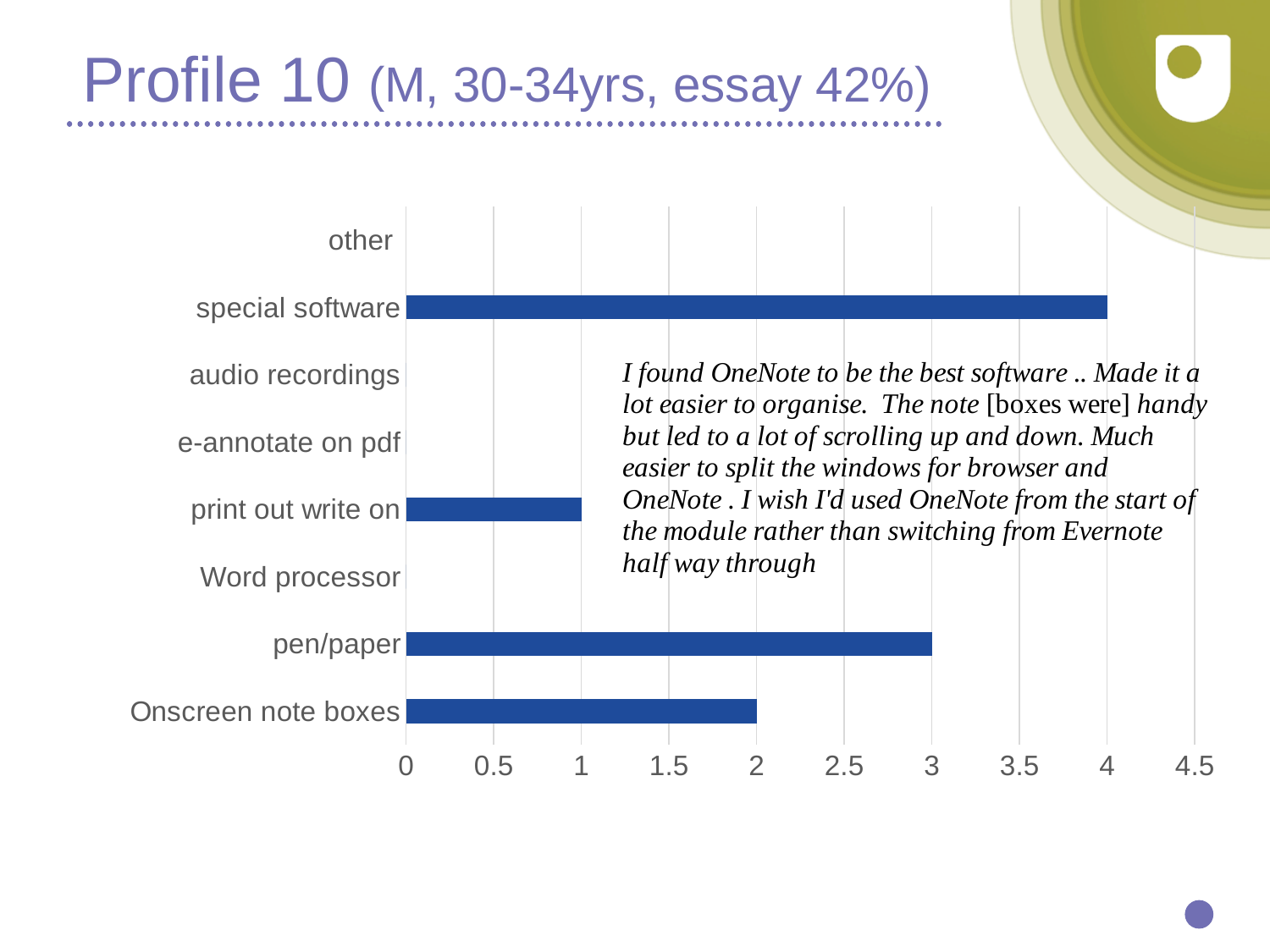
Is the value for special software greater or less than 3.5? greater How many categories are shown on the chart? 8 What is the highest value shown on the x axis? 4.5 What is the value for pen/paper? 3 What is the value for Onscreen note boxes? 2 Which category has the highest value? special software What is the difference between the values for special software and pen/paper? 1 What kind of chart is shown on the slide? bar chart Which is larger, the value for pen/paper or the value for Onscreen note boxes? pen/paper What is the value for print out write on? 1 What is the difference between the values for pen/paper and print out write on? 2 What is the value for special software? 4